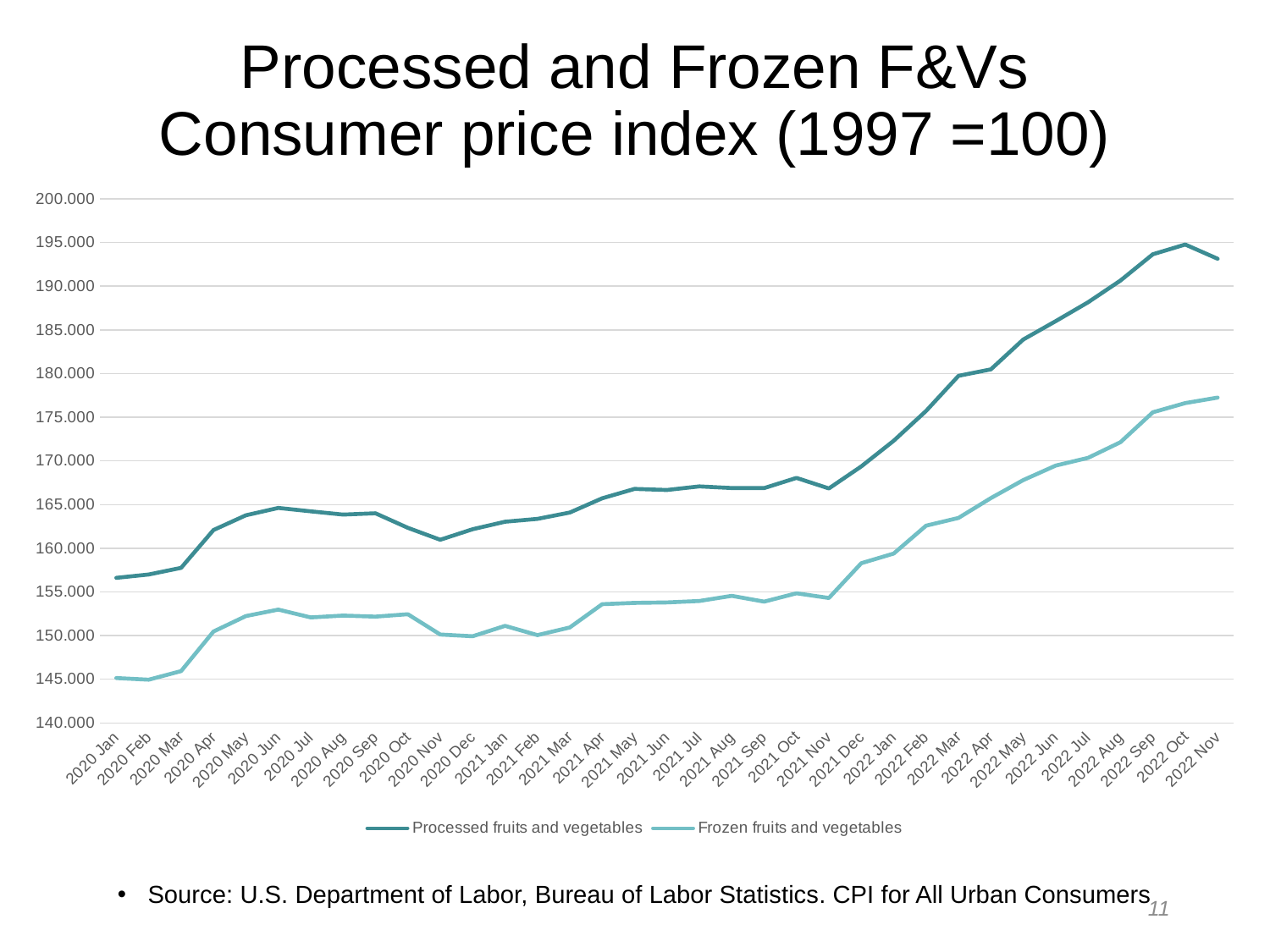
Is the value for Processed fruits and vegetables in 2022 Oct greater or less than 190.000? greater Which month has the highest value for Processed fruits and vegetables? 2022 Oct Which month has the highest value for Frozen fruits and vegetables? 2022 Nov Is the value for Frozen fruits and vegetables in 2022 Nov greater or less than 175.000? greater Which month has the lowest value for Processed fruits and vegetables? 2020 Jan How many series does the legend list? 2 What kind of chart is shown on the slide? Line chart What are the two series named in the legend? Processed fruits and vegetables; Frozen fruits and vegetables In 2021 Jun, which series has the larger value, Processed fruits and vegetables or Frozen fruits and vegetables? Processed fruits and vegetables How many monthly data points are plotted along the x axis? 35 Is the value for Frozen fruits and vegetables in 2020 Jan greater or less than 150.000? less Overall, do the values for Frozen fruits and vegetables rise or fall from 2020 Jan to 2022 Nov? Rise